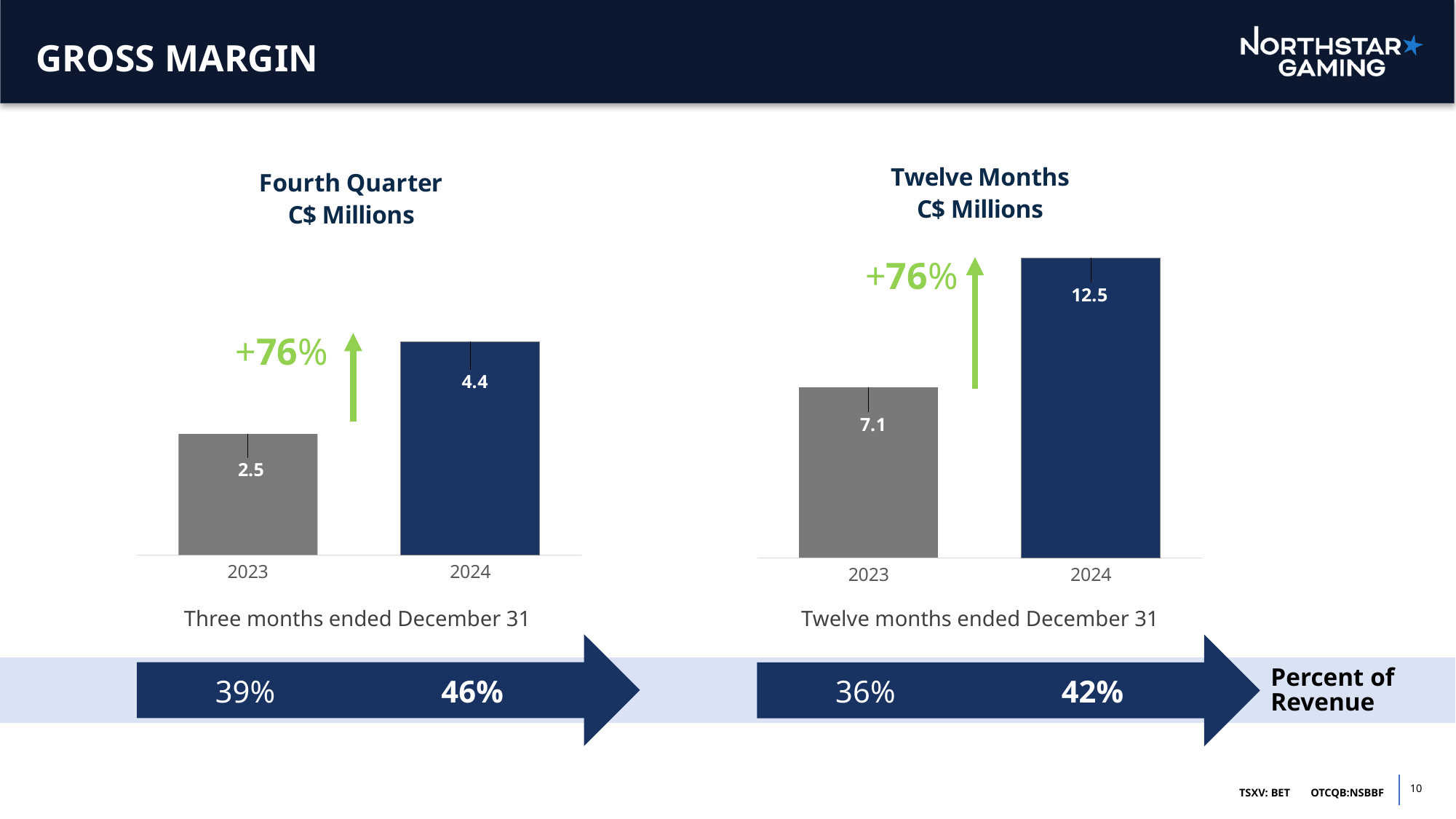
In the Twelve Months chart, what is the difference between the 2024 and 2023 values? 5.4 What percentage increase is annotated on the Fourth Quarter chart? +76% In the Fourth Quarter chart, what is the gross margin value for 2023? 2.5 In the Twelve Months chart, which year has the lower gross margin? 2023 In the Fourth Quarter chart, which year has the higher gross margin? 2024 How many bars are shown in the Fourth Quarter chart? 2 In the Twelve Months chart, what is the gross margin value for 2024? 12.5 What type of chart is the Twelve Months chart? bar chart In the Twelve Months chart, what is the gross margin value for 2023? 7.1 In the Twelve Months chart, is the value for 2024 larger or smaller than the value for 2023? larger In the Fourth Quarter chart, what is the difference between the 2024 and 2023 values? 1.9 In the Fourth Quarter chart, what is the gross margin value for 2024? 4.4